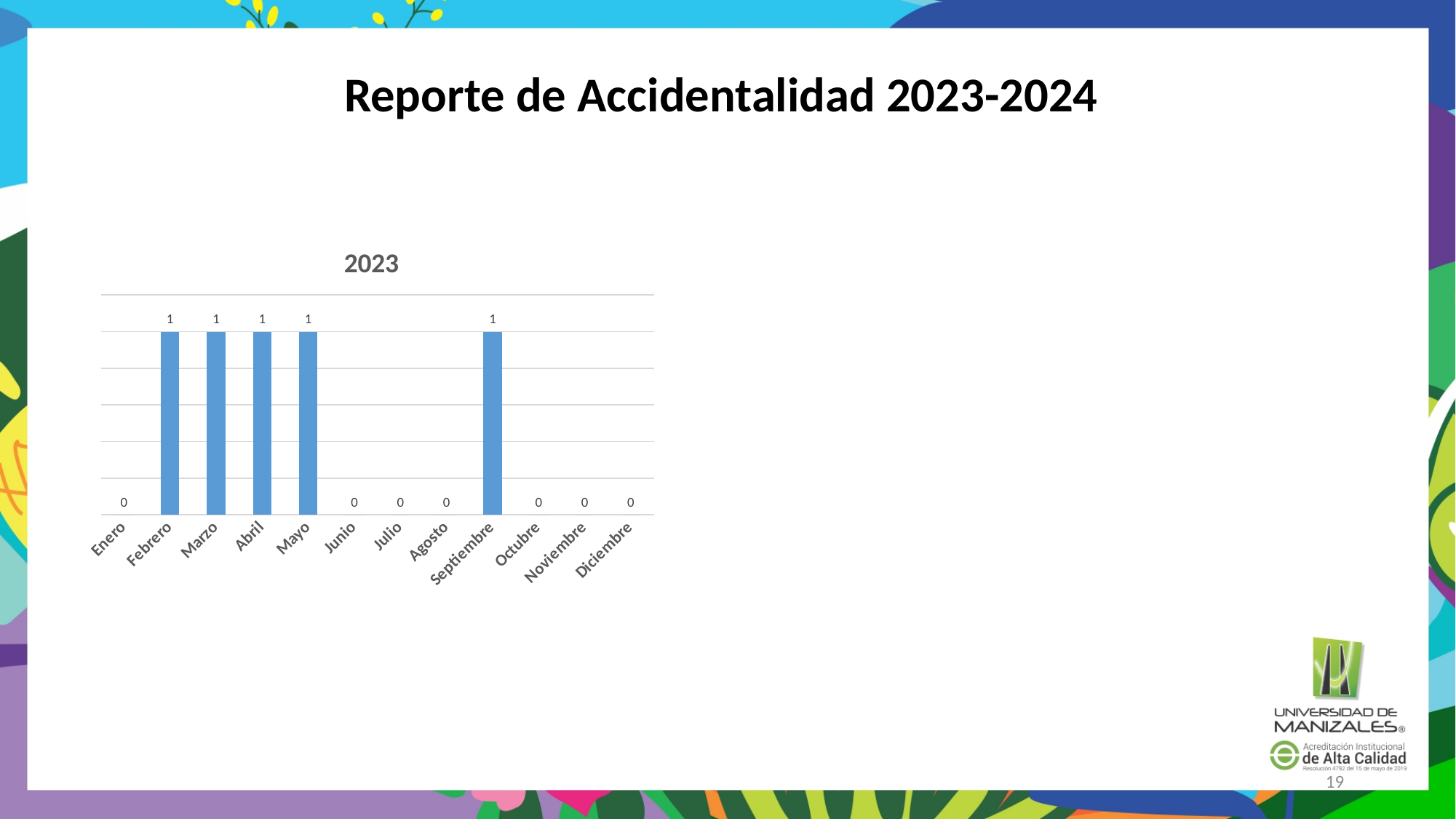
How many months in the 2023 chart have a value of 1? 5 What is the title of the slide? Reporte de Accidentalidad 2023-2024 What is the difference between the value for Marzo and the value for Julio in the 2023 chart? 1 What is the value for Enero in the 2023 chart? 0 What is the value for Septiembre in the 2023 chart? 1 What kind of chart is shown on the slide? bar chart What is the value for Febrero in the 2023 chart? 1 What is the title of the chart on the slide? 2023 Which is larger in the 2023 chart, the value for Mayo or the value for Octubre? Mayo How many categories are shown on the x axis of the 2023 chart? 12 What is the value for Diciembre in the 2023 chart? 0 What is the value for Junio in the 2023 chart? 0